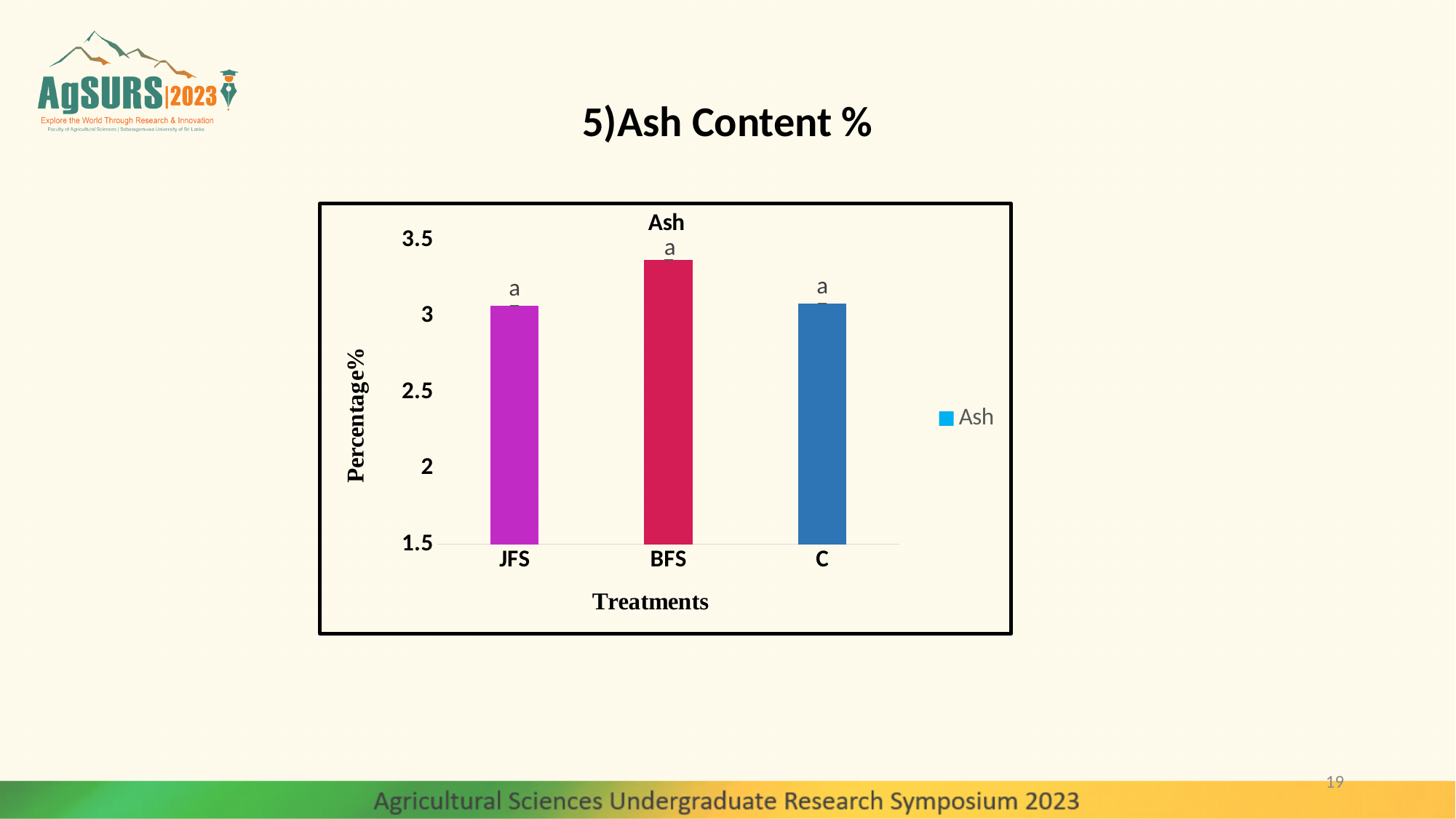
Is the ash content for BFS greater or less than 3? greater How many series does the chart legend list? 1 Which treatment has the highest ash content? BFS Is the ash content for C greater or less than 2.5? greater What type of chart is shown on the slide? bar chart Which has a higher ash content, BFS or JFS? BFS Is the ash content for JFS greater or less than 2.5? greater Which has a higher ash content, C or BFS? BFS What is the title of the chart? Ash How many treatments are shown on the x axis of the chart? 3 What is the label of the x axis of the chart? Treatments